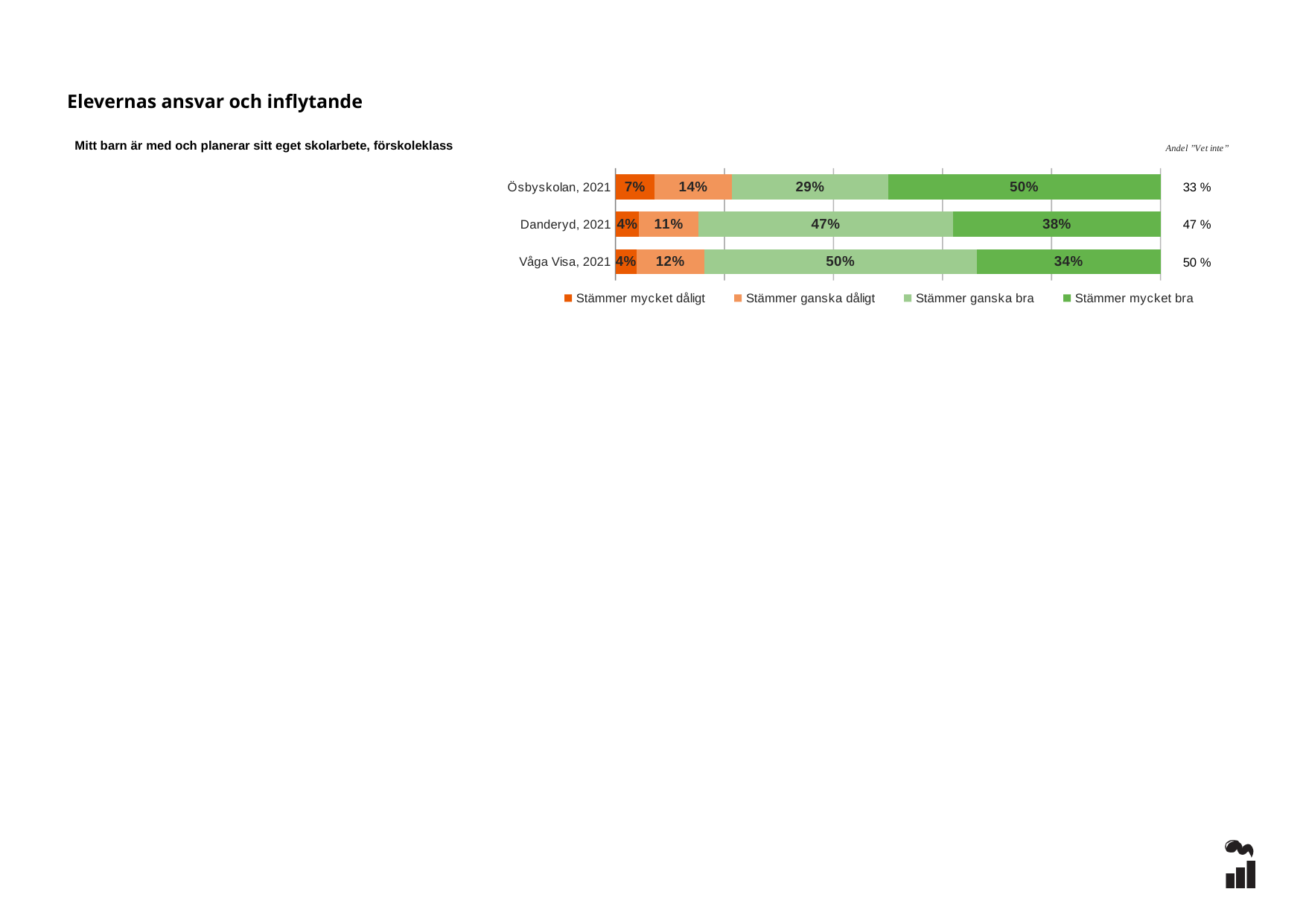
What is the difference between the "Stämmer mycket bra" values for Ösbyskolan, 2021 and Våga Visa, 2021? 16% What is the value of "Stämmer mycket dåligt" for Ösbyskolan, 2021? 7% What kind of chart is shown on the slide? Stacked bar chart What is the value of "Stämmer ganska dåligt" for Våga Visa, 2021? 12% What is the value of "Stämmer mycket bra" for Ösbyskolan, 2021? 50% What is the "Andel 'Vet inte'" value shown for Danderyd, 2021? 47 % Which category has the lowest value for "Stämmer ganska bra"? Ösbyskolan, 2021 How many categories (rows) does the chart show? 3 Which category has the highest value for "Stämmer mycket bra"? Ösbyskolan, 2021 How many series does the legend list? 4 What is the value of "Stämmer ganska bra" for Danderyd, 2021? 47% Which is larger: "Stämmer ganska bra" for Danderyd, 2021 or for Våga Visa, 2021? Våga Visa, 2021